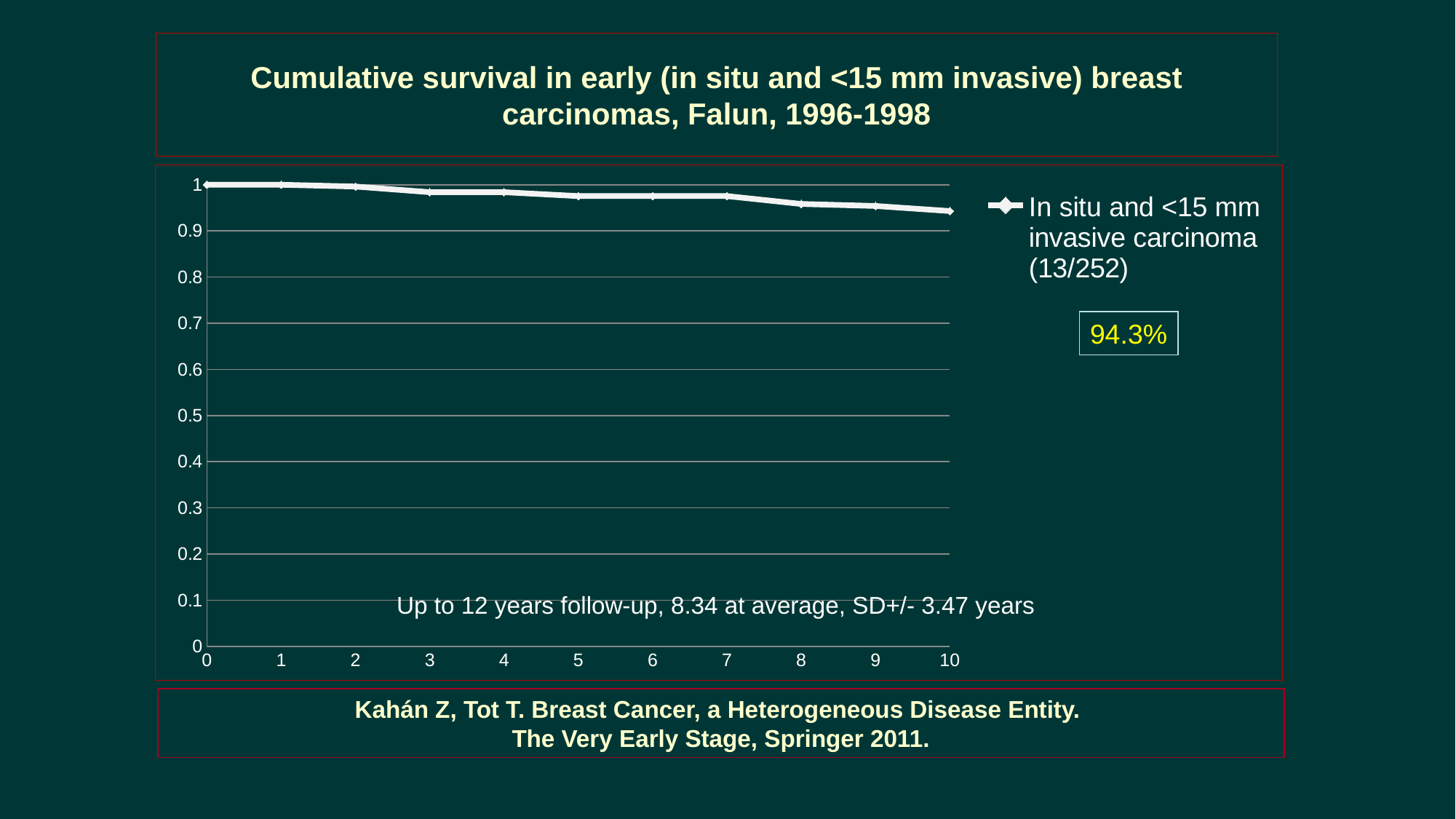
Is the cumulative survival value at year 10 greater or less than 0.9? greater Do the cumulative survival values rise or fall as the years increase along the x axis? fall What percentage is shown in the highlighted box next to the legend? 94.3% What is the cumulative survival value at year 0? 1 At which year is the cumulative survival highest? Years 0 and 1 (both at 1) At which year is the cumulative survival lowest? 10 What is the name of the series shown in the legend? In situ and <15 mm invasive carcinoma (13/252) How many data points are plotted along the x axis (years 0 to 10)? 11 What is the title of the chart? Cumulative survival in early (in situ and <15 mm invasive) breast carcinomas, Falun, 1996-1998 Is the cumulative survival value at year 5 greater or less than 0.8? greater What kind of chart is shown on the slide? line chart How many series does the legend list? 1